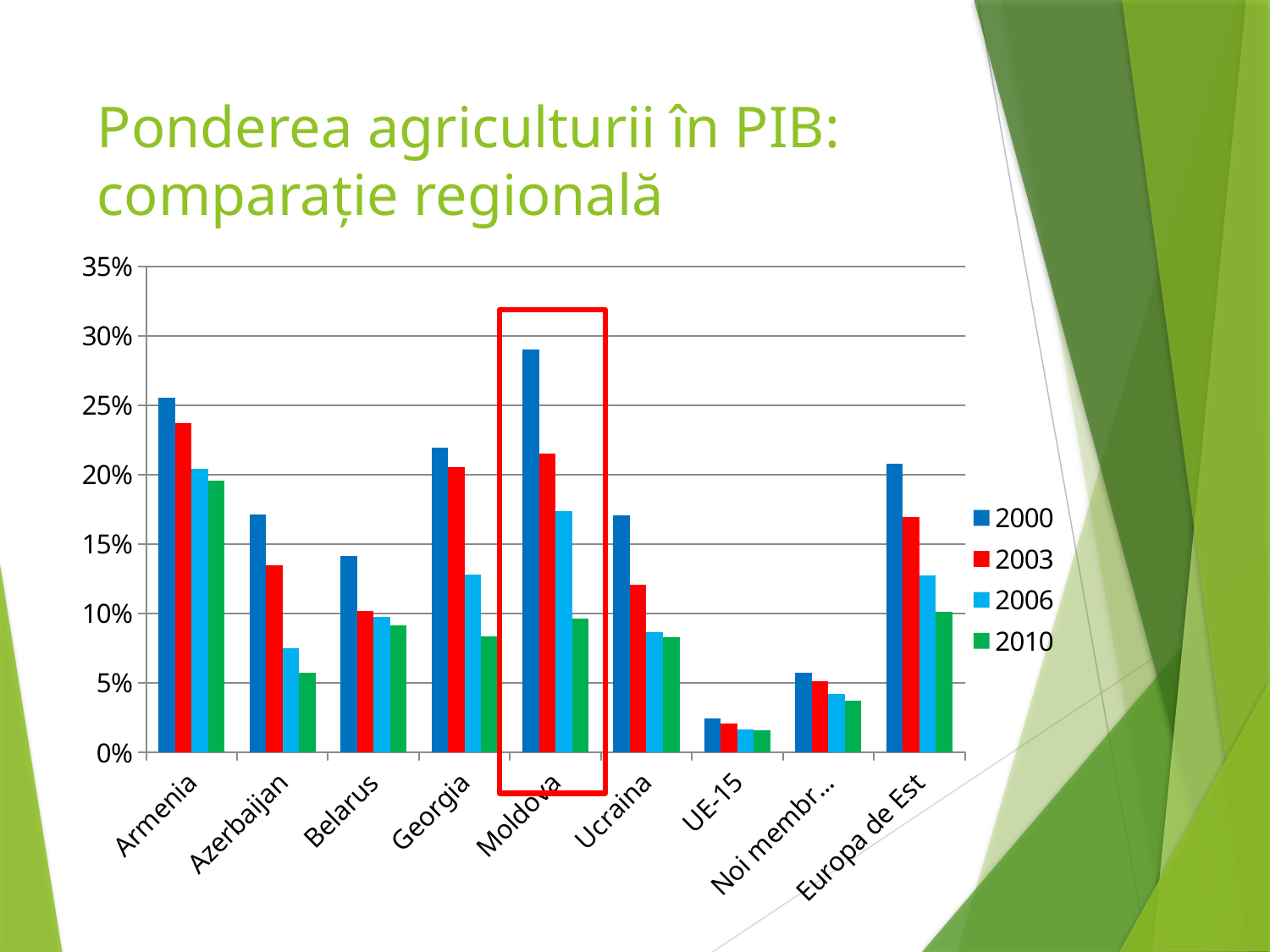
Do the values for Moldova rise or fall from 2000 to 2010? fall Which is larger: the 2000 value for Armenia or the 2000 value for Georgia? Armenia How many series does the legend list? 4 Which is larger: the 2003 value for Moldova or the 2003 value for Ucraina? Moldova Which category has the highest value for 2000? Moldova Which category has the lowest value for 2000? UE-15 Which category is highlighted with a red box on the chart? Moldova Is the value for Moldova in 2000 greater or less than 25%? greater Is the value for Azerbaijan in 2010 greater or less than 10%? less Is the value for UE-15 in 2000 greater or less than 5%? less How many countries or regions are shown on the x axis? 9 What kind of chart is shown on the slide? bar chart